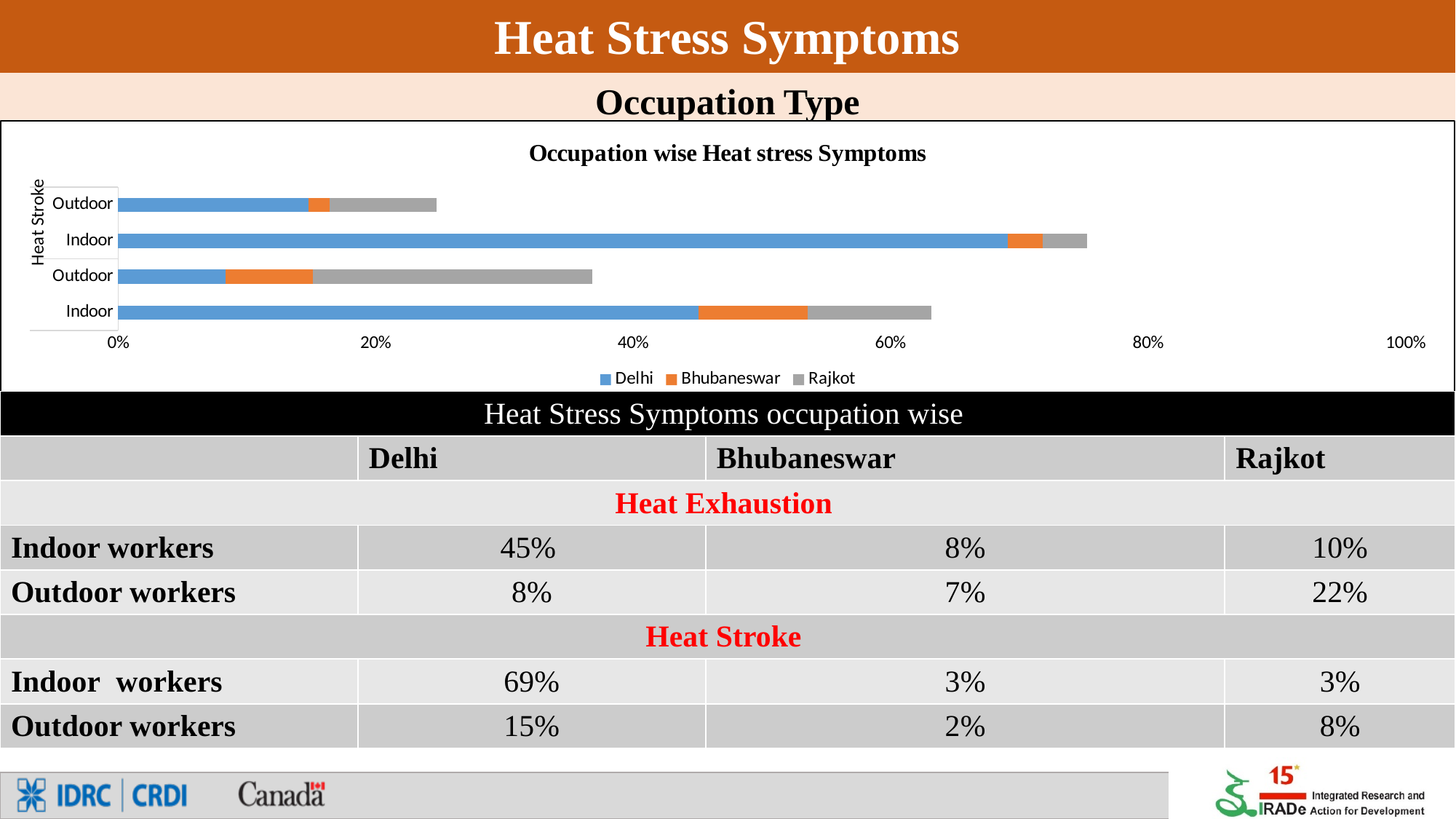
Within the Heat Stroke group, which bar is longer in total, Indoor or Outdoor? Indoor Is the total length of the Heat Stroke Indoor bar greater or less than 60%? greater Is the total length of the Heat Stroke Outdoor bar greater or less than 40%? less What are the series names in the chart legend? Delhi, Bhubaneswar, Rajkot How many bars are plotted in the chart? 4 Which bar in the chart is the shortest in total? Heat Stroke Outdoor What is the Delhi value for Heat Stroke among Indoor workers? 69% How many series does the chart legend list? 3 Which bar in the chart extends the furthest? Heat Stroke Indoor What is the total of the Heat Stroke Indoor stacked bar (Delhi + Bhubaneswar + Rajkot)? 75% What is the title of the chart? Occupation wise Heat stress Symptoms What type of chart is shown on the slide? bar chart